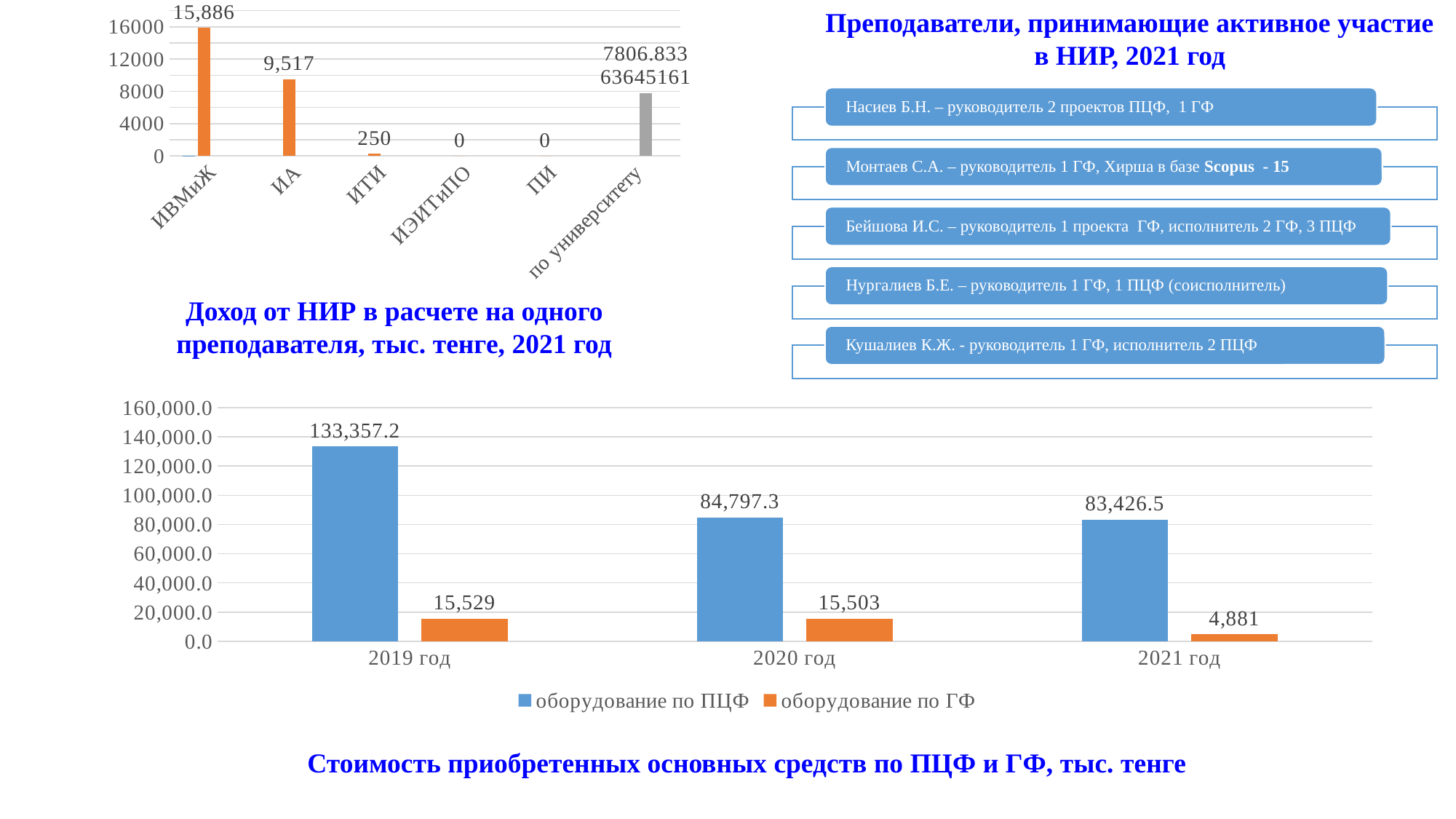
In the chart 'Доход от НИР в расчете на одного преподавателя', what is the value for ИВМиЖ? 15,886 In the chart 'Доход от НИР в расчете на одного преподавателя', what is the difference between ИВМиЖ and ИА? 6,369 In the chart 'Стоимость приобретенных основных средств по ПЦФ и ГФ', what is the value of оборудование по ГФ for 2021 год? 4,881 In the chart 'Стоимость приобретенных основных средств по ПЦФ и ГФ', what is the difference between оборудование по ПЦФ and оборудование по ГФ in 2019 год? 117,828.2 What kind of chart is 'Стоимость приобретенных основных средств по ПЦФ и ГФ'? bar chart In the chart 'Стоимость приобретенных основных средств по ПЦФ и ГФ', what is the value of оборудование по ПЦФ for 2019 год? 133,357.2 In the chart 'Стоимость приобретенных основных средств по ПЦФ и ГФ', does the value of оборудование по ПЦФ rise or fall from 2019 год to 2021 год? fall In the chart 'Стоимость приобретенных основных средств по ПЦФ и ГФ', how many series does the legend list? 2 In the chart 'Доход от НИР в расчете на одного преподавателя', how many categories are shown on the x axis? 6 In the chart 'Доход от НИР в расчете на одного преподавателя', which category has the highest value? ИВМиЖ In the chart 'Стоимость приобретенных основных средств по ПЦФ и ГФ', which year has the lowest value for оборудование по ГФ? 2021 год In the chart 'Доход от НИР в расчете на одного преподавателя', what is the value for ИА? 9,517